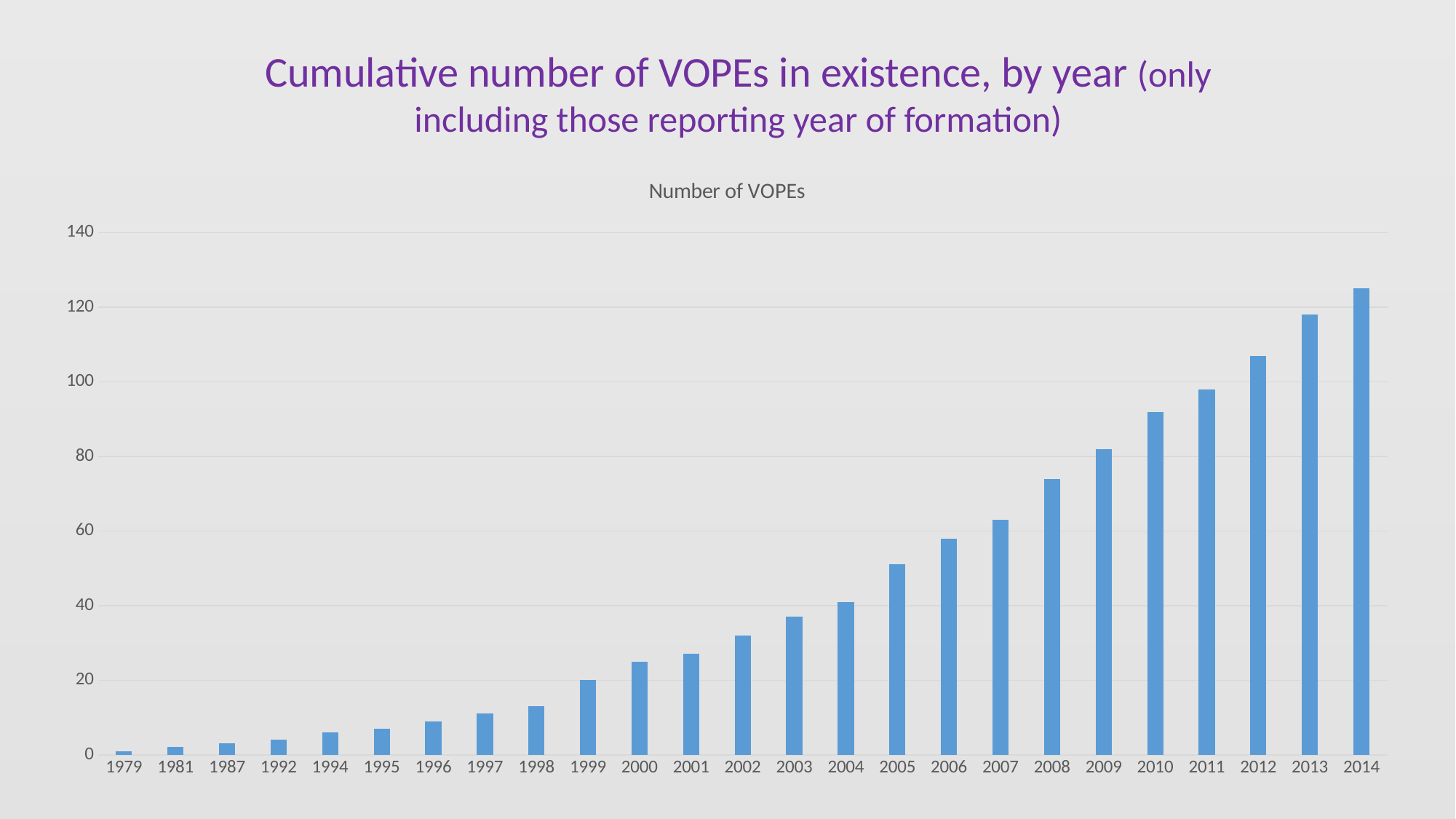
Is the value for 1998 greater or less than 20? less Which year has the lowest cumulative number of VOPEs? 1979 Is the value for 2005 greater or less than 40? greater How many years are shown along the x axis of the chart? 25 Is the value for 2012 greater or less than 100? greater Do the values rise or fall as the years progress along the x axis? rise What kind of chart is shown on the slide? bar chart What is the title shown directly above the plot area of the chart? Number of VOPEs Which is larger, the value for 2010 or the value for 2006? 2010 Which year has the highest cumulative number of VOPEs? 2014